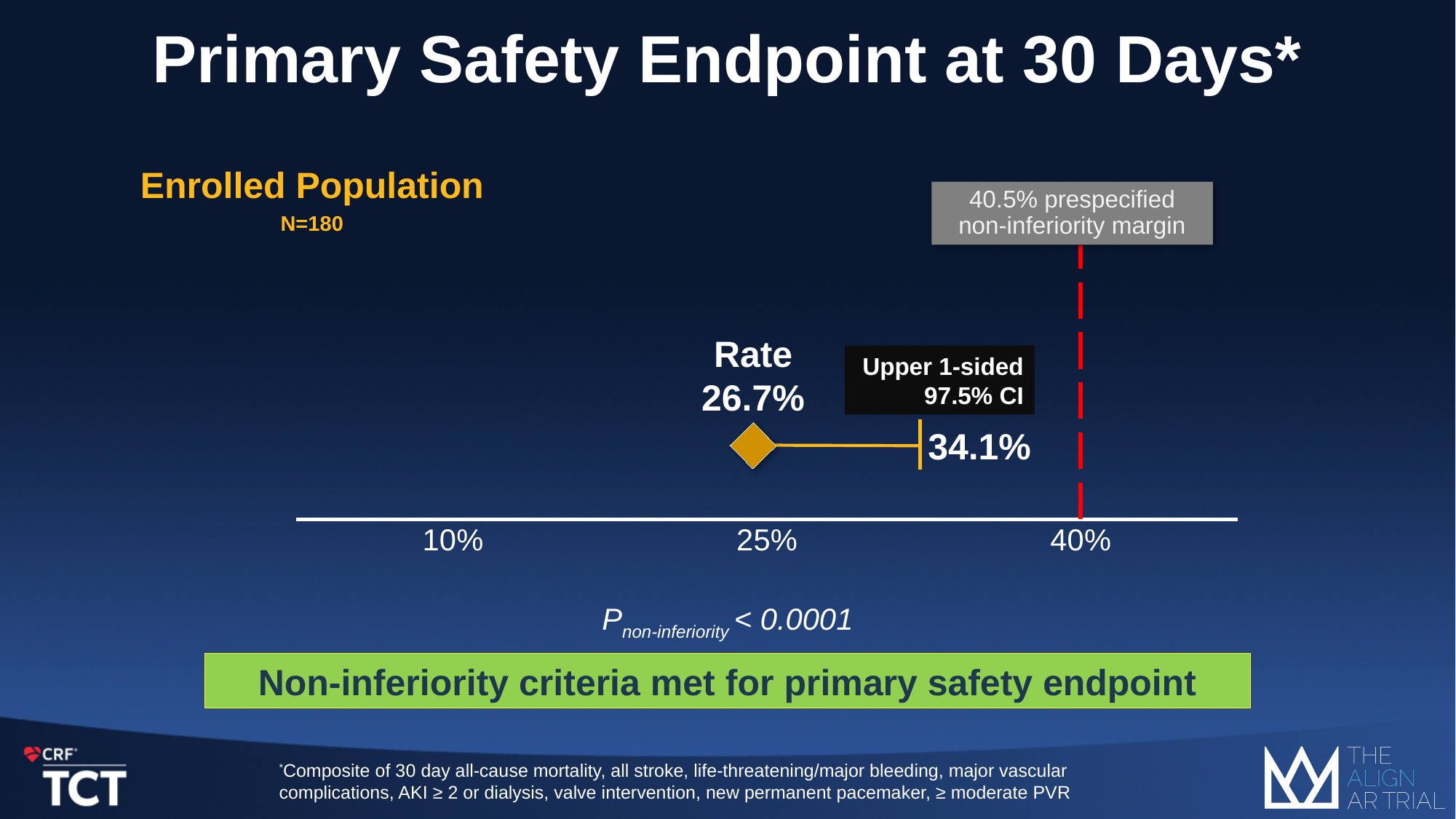
What is the upper 1-sided 97.5% confidence interval bound shown on the chart? 34.1% What are the three axis tick labels shown on the chart's horizontal axis? 10%, 25%, 40% What is the primary safety endpoint rate at 30 days shown on the chart? 26.7% What is the difference between the upper 1-sided 97.5% CI bound and the rate? 7.4% What is the difference between the prespecified non-inferiority margin and the upper 1-sided 97.5% CI bound? 6.4% What is the prespecified non-inferiority margin marked by the red dashed line? 40.5% What is the non-inferiority p-value shown below the chart? < 0.0001 What colour is the dashed vertical line marking the non-inferiority margin? Red How many patients are in the enrolled population shown on the chart? N=180 Is the rate of 26.7% greater or less than the 25% axis tick? greater Is the upper 1-sided 97.5% CI bound greater or less than 40%? less Is the upper 1-sided 97.5% CI bound greater or less than the 40.5% non-inferiority margin? less